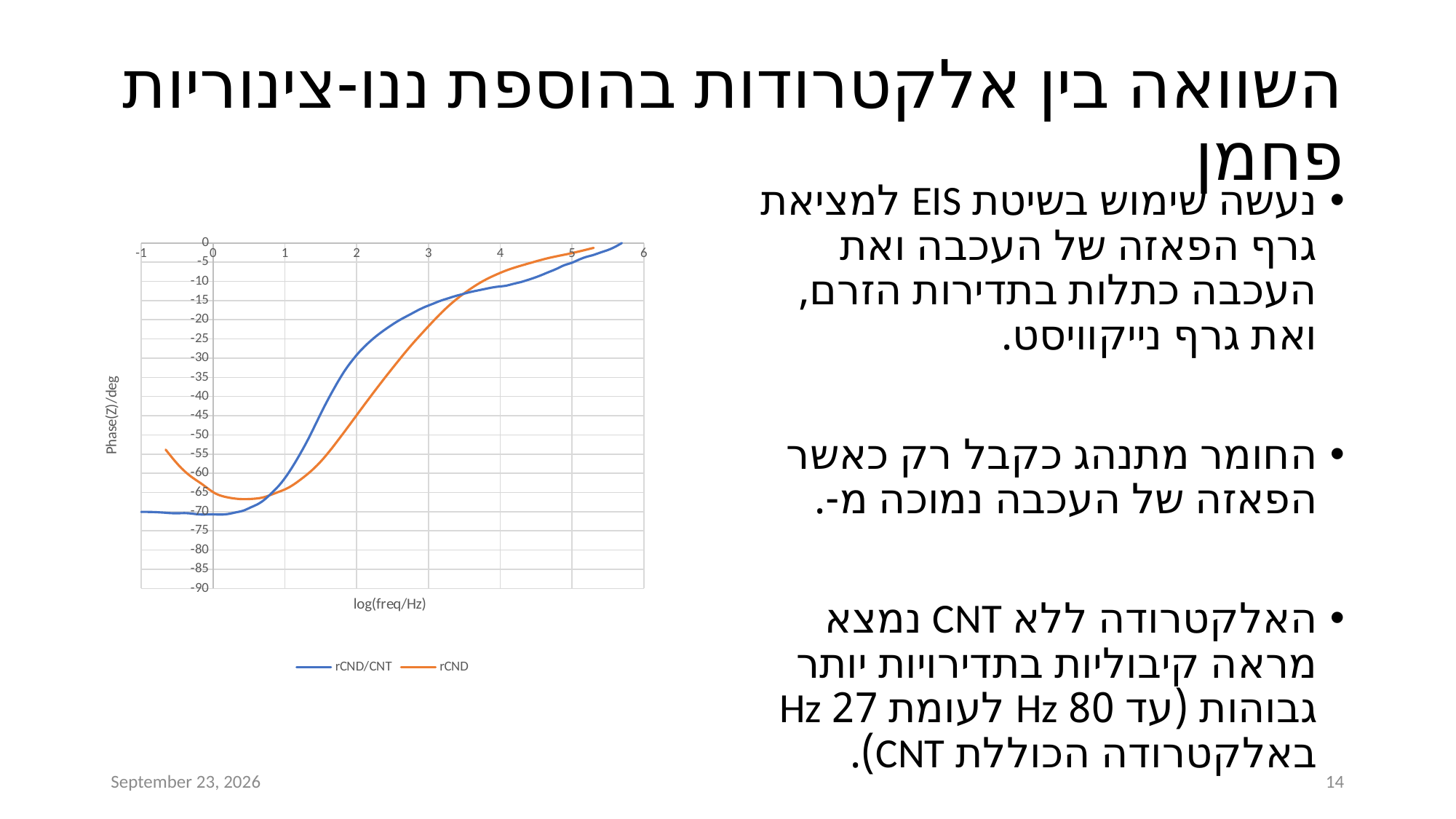
Is the value of the rCND/CNT series at log(freq/Hz) = 3 greater or less than -25? greater At log(freq/Hz) = 2, which series has the higher (less negative) phase value, rCND/CNT or rCND? rCND/CNT Which series is drawn in orange? rCND How many series does the chart's legend list? 2 Between log(freq/Hz) = 1 and log(freq/Hz) = 5, do the values of the rCND/CNT series rise or fall? rise What is the label of the x axis of the chart? log(freq/Hz) Is the value of the rCND series at log(freq/Hz) = 2 greater or less than -35? less Is the value of the rCND/CNT series at log(freq/Hz) = 2 greater or less than -40? greater Between log(freq/Hz) = 1 and log(freq/Hz) = 5, do the values of the rCND series rise or fall? rise What are the names of the two series in the legend? rCND/CNT and rCND What kind of chart is shown on the slide? line chart